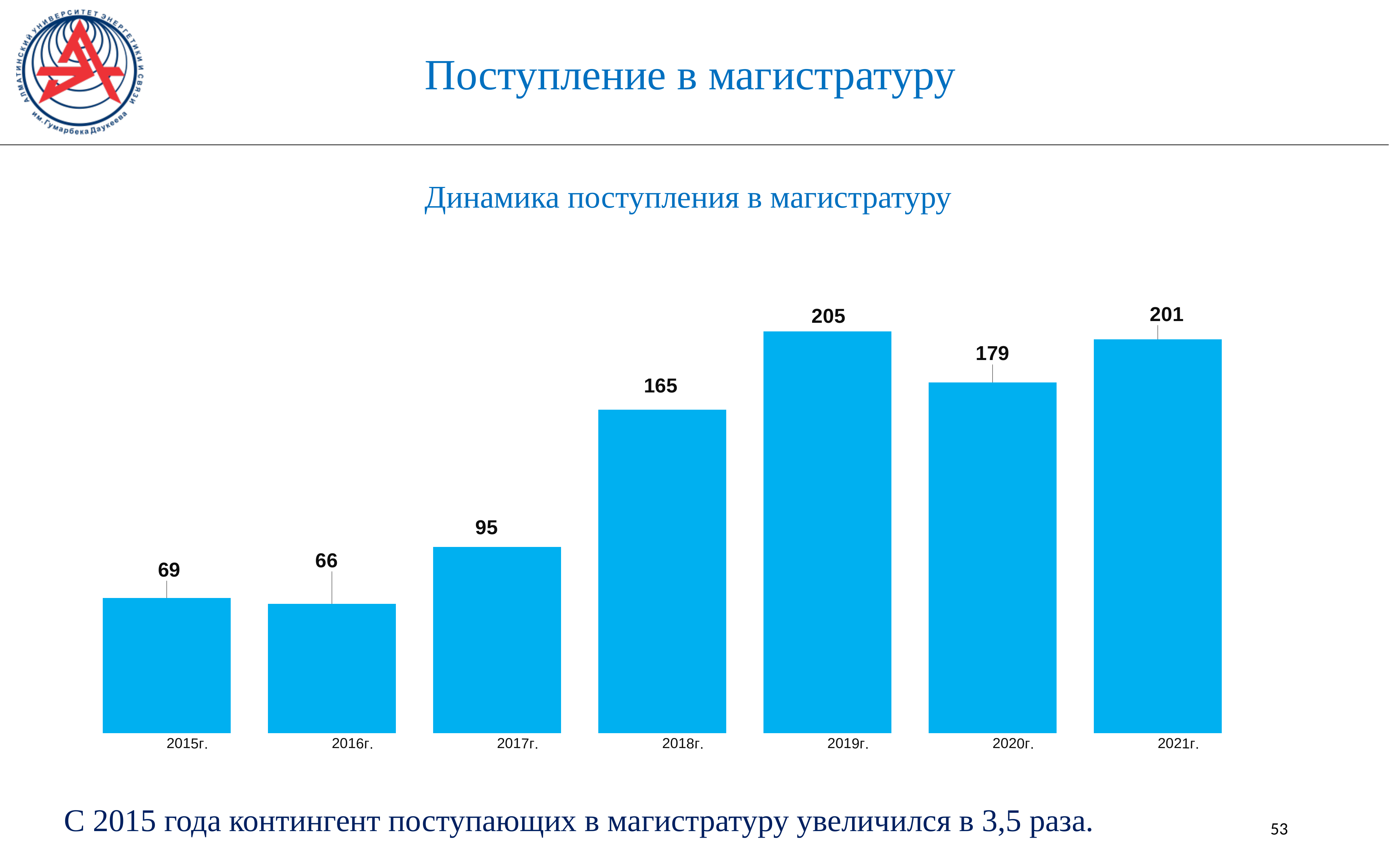
What is the title of the chart? Динамика поступления в магистратуру What is the difference between the values for 2018г. and 2017г.? 70 What is the value for 2019г.? 205 Which year has the highest value? 2019г. Do the values generally rise or fall from 2015г. to 2019г.? rise What kind of chart is shown on the slide? bar chart What is the value for 2020г.? 179 Which is larger, the value for 2021г. or the value for 2020г.? 2021г. What is the difference between the values for 2019г. and 2020г.? 26 How many years are shown on the chart? 7 What is the value for 2015г.? 69 Which year has the lowest value? 2016г.